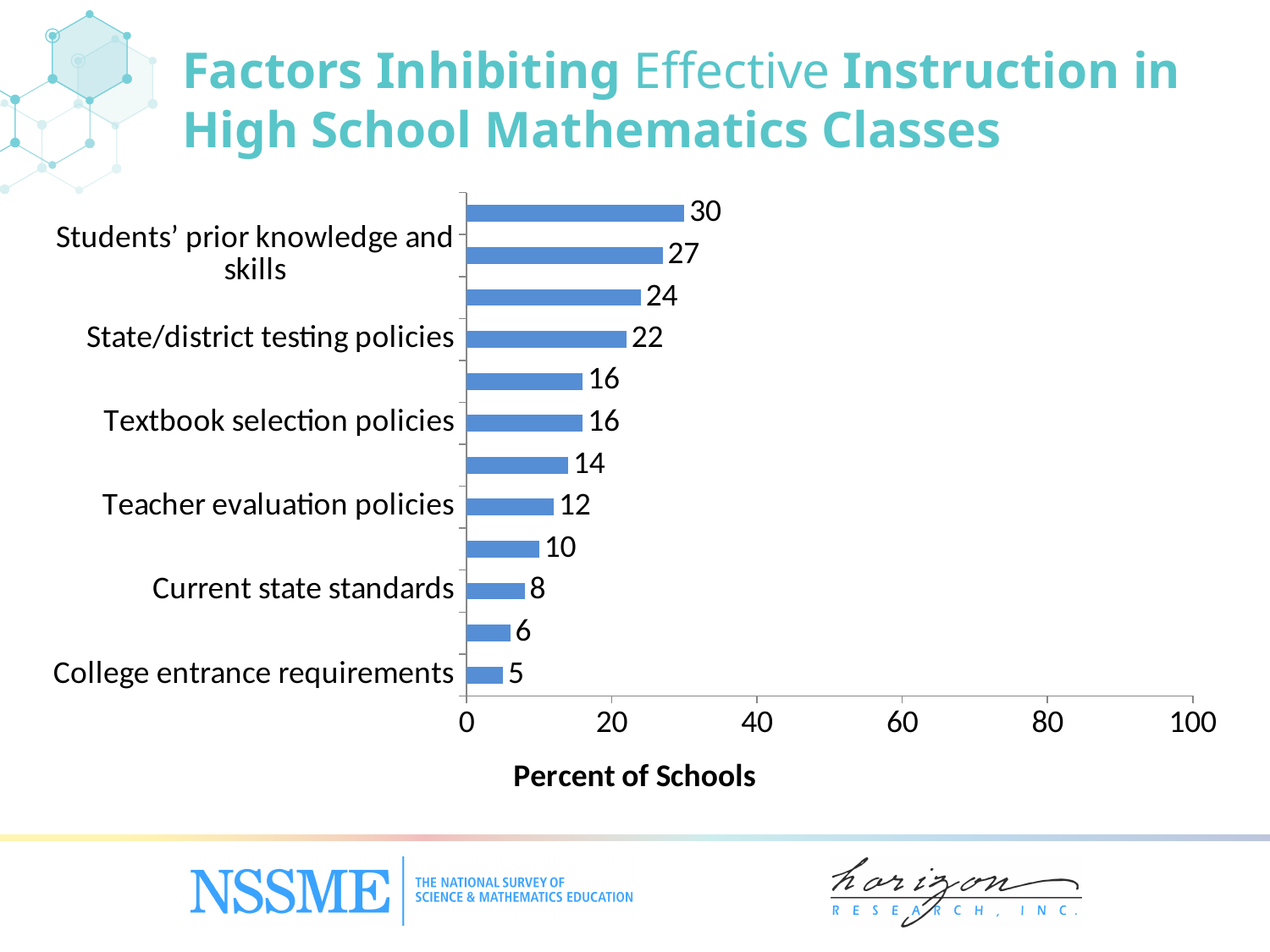
Which is larger, the value for Textbook selection policies or the value for Current state standards? Textbook selection policies How many bars are plotted on the chart? 12 What is the largest value shown on the chart? 30 Which labeled category has the lowest value? College entrance requirements What kind of chart is shown on the slide? bar chart What is the value for Teacher evaluation policies? 12 What is the value for Textbook selection policies? 16 What is the value for College entrance requirements? 5 What is the value for Students' prior knowledge and skills? 27 What is the value for Current state standards? 8 What is the value for State/district testing policies? 22 What is the difference between the values for State/district testing policies and Teacher evaluation policies? 10